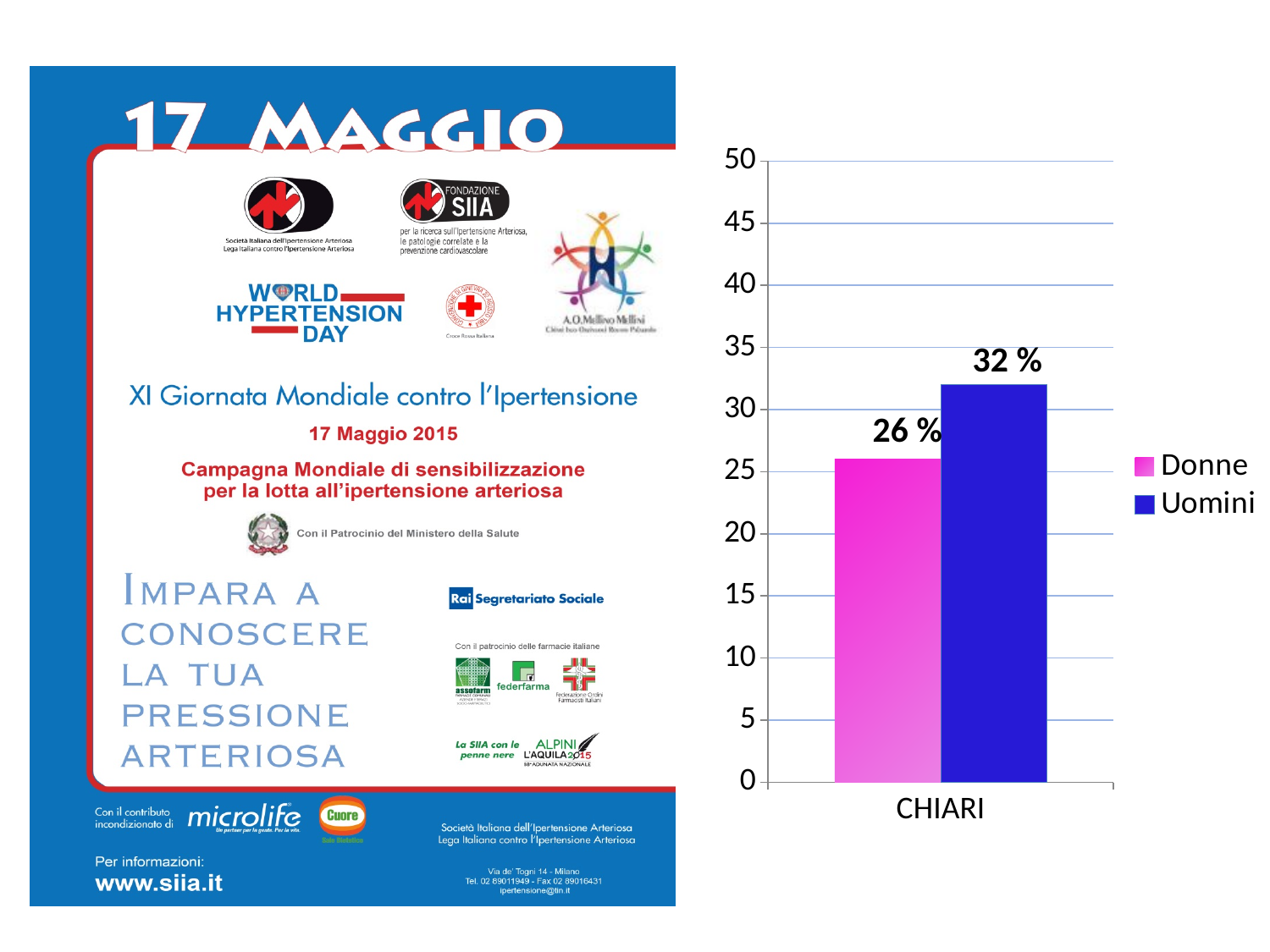
What is the difference between the Uomini and Donne values for CHIARI? 6 % What is the value for Donne in the CHIARI chart? 26 % Is the value for Donne greater or less than 30? less What is the value for Uomini in the CHIARI chart? 32 % How many series does the legend list? 2 Which series has the higher value for CHIARI, Donne or Uomini? Uomini What kind of chart is shown on the slide? bar chart How many categories are shown on the x axis of the chart? 1 Which series has the lowest value in the chart? Donne Is the value for Uomini greater or less than 30? greater What is the category label on the x axis of the chart? CHIARI What colour represents Uomini in the chart? blue